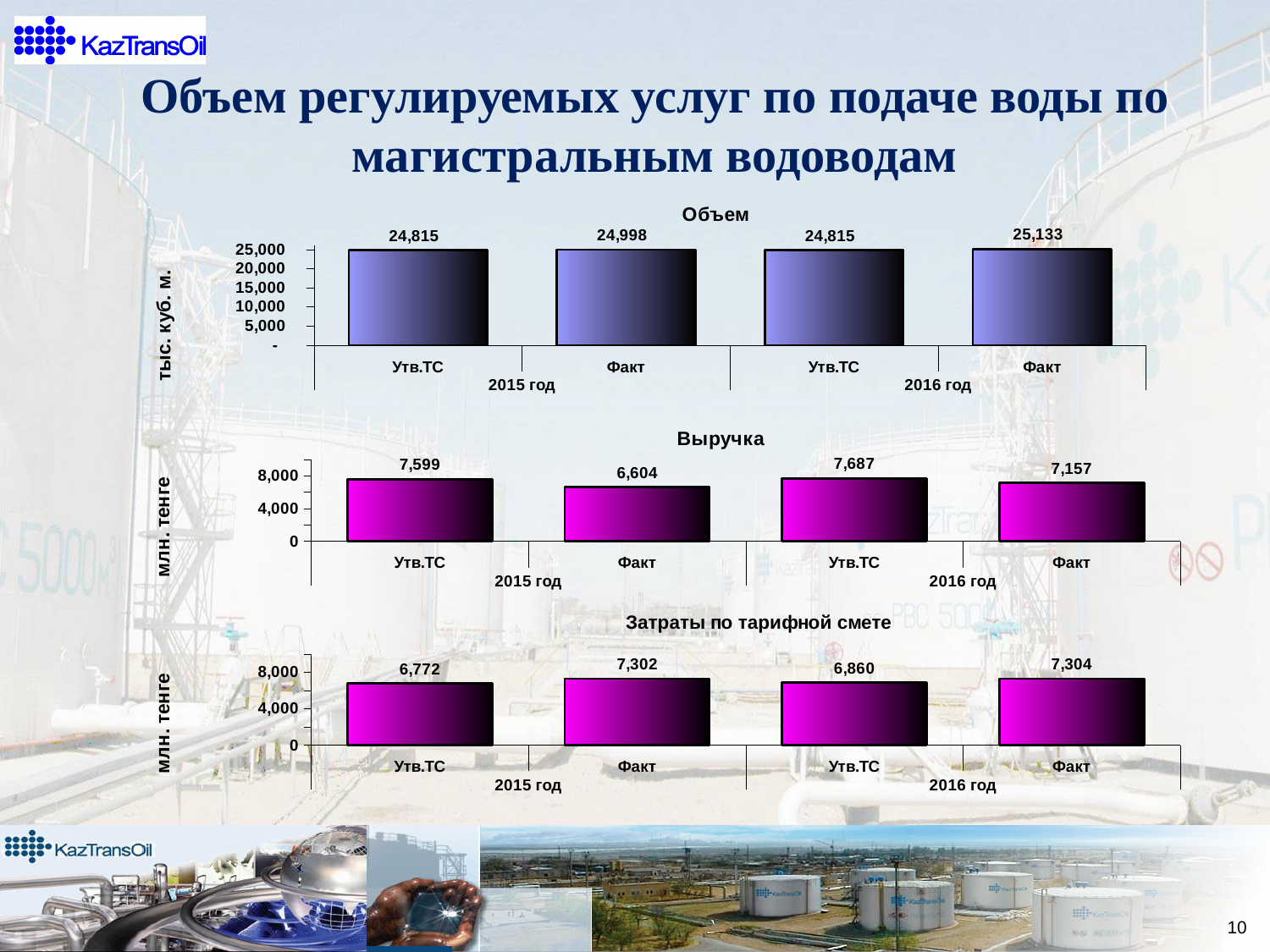
In the "Объем" chart, which bar has the highest value? Факт 2016 год In the "Выручка" chart, which bar has the lowest value? Факт 2015 год In the "Объем" chart, what is the value for Факт in 2016 год? 25,133 What is the y-axis unit label of the "Объем" chart? тыс. куб. м. What type of chart is the "Объем" chart? Bar chart In the "Затраты по тарифной смете" chart, what is the difference between Факт 2016 год and Утв.ТС 2016 год? 444 In the "Выручка" chart, what is the value for Утв.ТС in 2016 год? 7,687 How many bars are plotted in the "Выручка" chart? 4 In the "Выручка" chart, what is the difference between Утв.ТС 2015 год and Факт 2015 год? 995 In the "Затраты по тарифной смете" chart, which is larger: Факт 2016 год or Утв.ТС 2016 год? Факт 2016 год In the "Объем" chart, what is the difference between Факт 2015 год and Утв.ТС 2015 год? 183 In the "Затраты по тарифной смете" chart, what is the value for Утв.ТС in 2015 год? 6,772